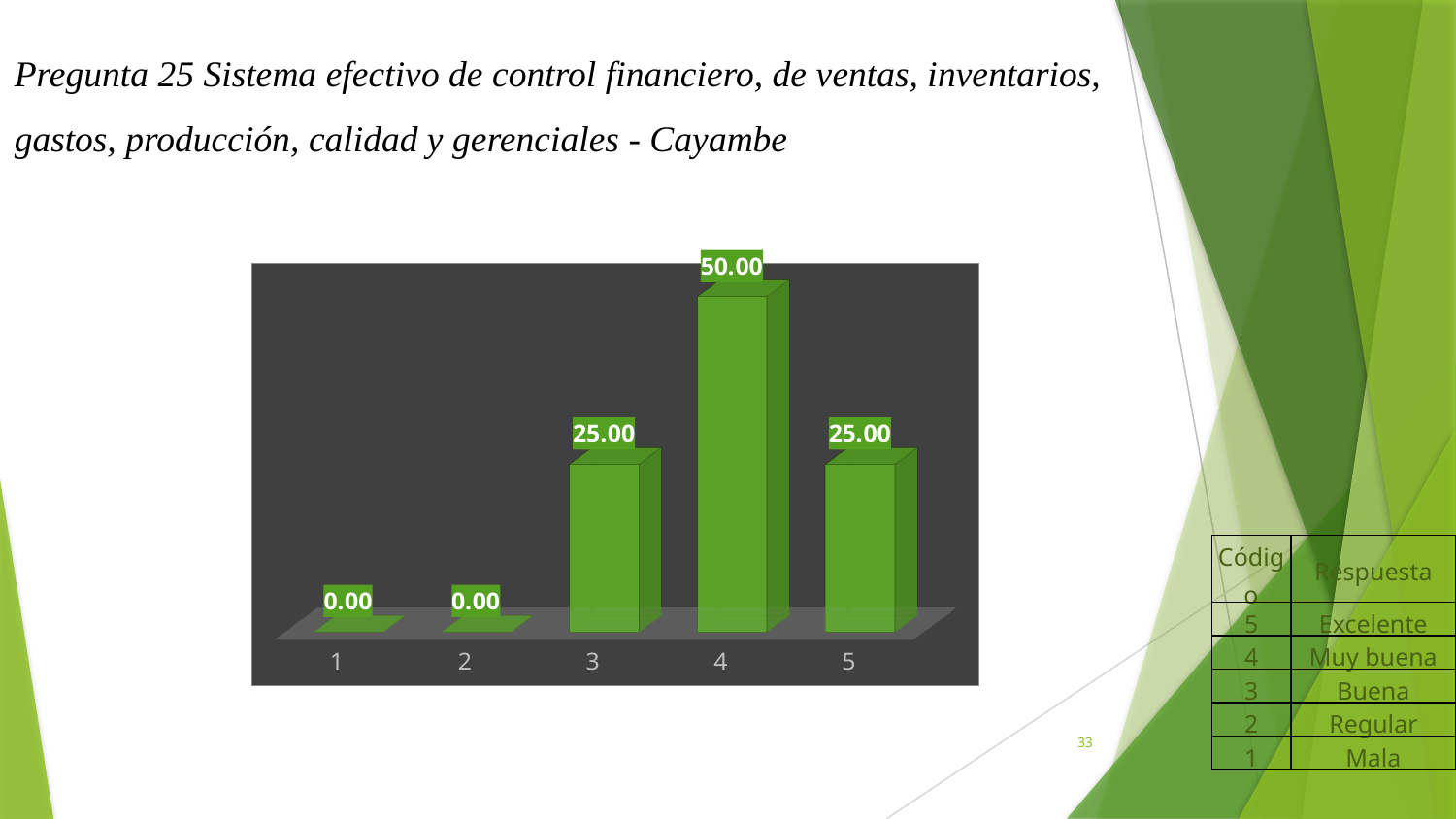
Which is larger, the value for category 4 or the value for category 5? category 4 What is the value for category 3? 25.00 What is the difference between the values for category 4 and category 3? 25.00 What colour are the bars in the chart? green What is the total of the values for categories 3, 4 and 5? 100.00 What is the value for category 5? 25.00 How many categories have a value of 0.00? 2 What is the value for category 4? 50.00 What kind of chart is shown on the slide? bar chart How many categories are shown on the x axis? 5 Which category has the highest value? 4 What is the value for category 1? 0.00